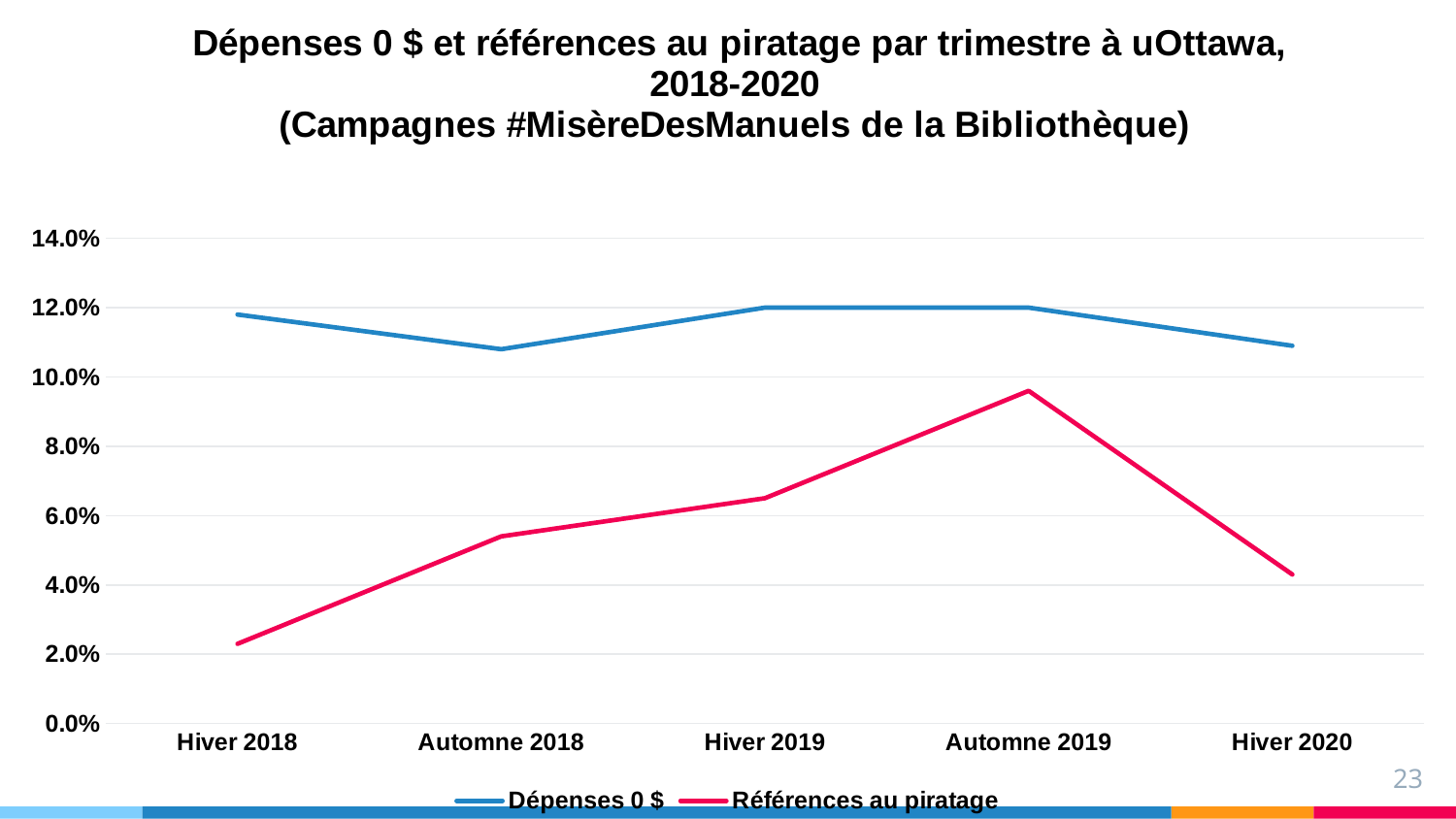
Is the value for 'Références au piratage' in Automne 2019 greater or less than 8.0%? greater Does the 'Références au piratage' series rise or fall from Hiver 2018 to Automne 2019? Rise In which quarter is the 'Références au piratage' series at its lowest value? Hiver 2018 In Hiver 2019, which series has the larger value, 'Dépenses 0 $' or 'Références au piratage'? Dépenses 0 $ Is the value for 'Références au piratage' in Hiver 2020 greater or less than 6.0%? less Is the value for 'Références au piratage' in Hiver 2018 greater or less than 4.0%? less How many series does the legend list? 2 How many quarters are plotted along the x axis? 5 What colour is the line for 'Références au piratage'? Pink/red What kind of chart is shown on the slide? Line chart In which quarter does the 'Références au piratage' series reach its highest value? Automne 2019